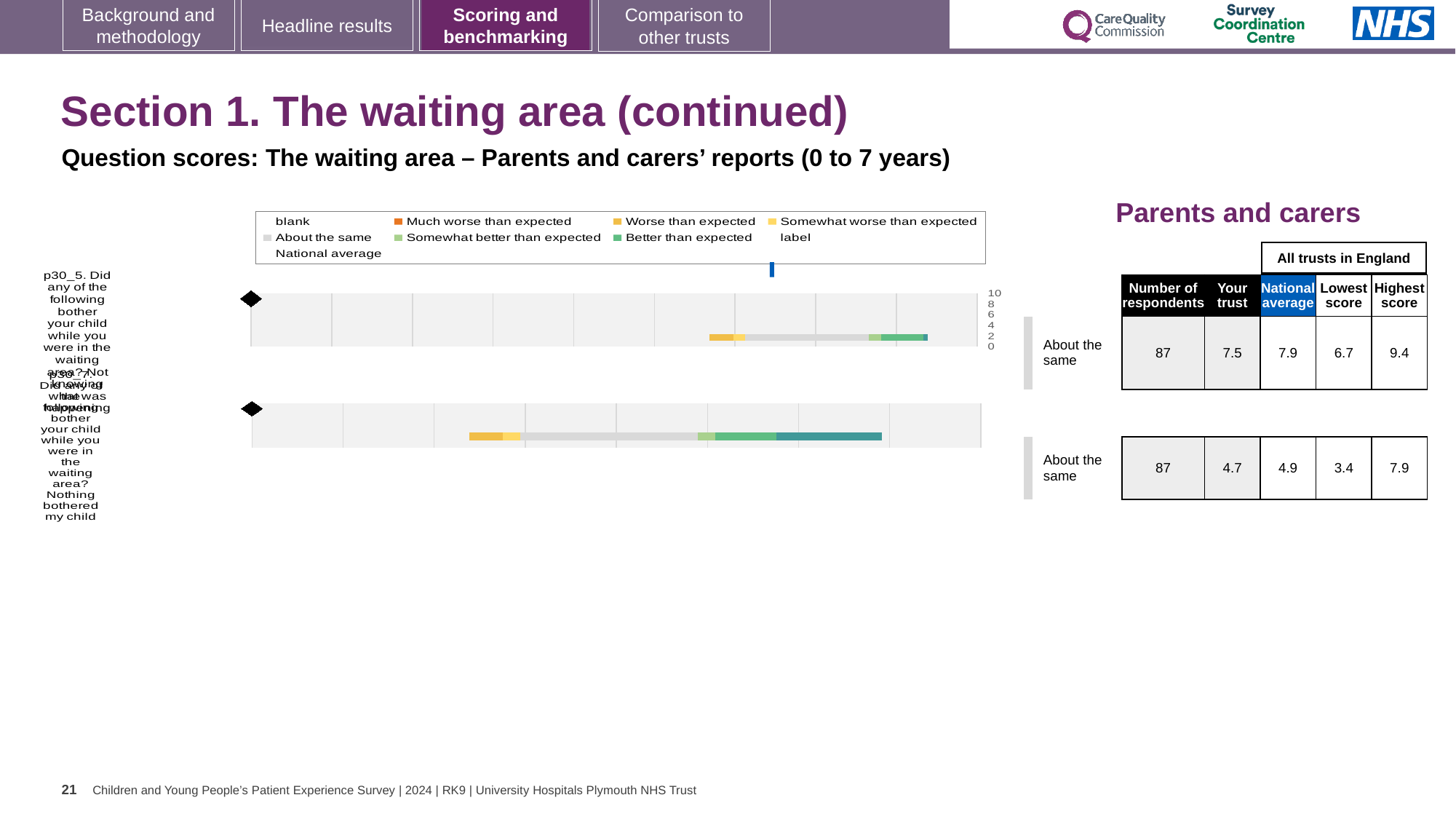
What kind of chart is shown on the slide? bar chart What is the national average for the first question (p30_5)? 7.9 How many entries does the chart legend list? 9 What is the 'Your trust' score for the second question (p30_7, Nothing bothered my child)? 4.7 What is the 'Your trust' score for the first question (p30_5, Not knowing what was happening)? 7.5 Which is larger for the second question (p30_7): the trust's score or the national average? national average What is the highest score across all trusts in England for the second question (p30_7)? 7.9 What is the lowest score across all trusts in England for the first question (p30_5)? 6.7 What benchmark category is shown for both questions in the table? About the same How many respondents answered the second question (p30_7)? 87 How many question rows (bars) are plotted in the chart? 2 What is the difference between the highest score (9.4) and the lowest score (6.7) for the first question (p30_5)? 2.7